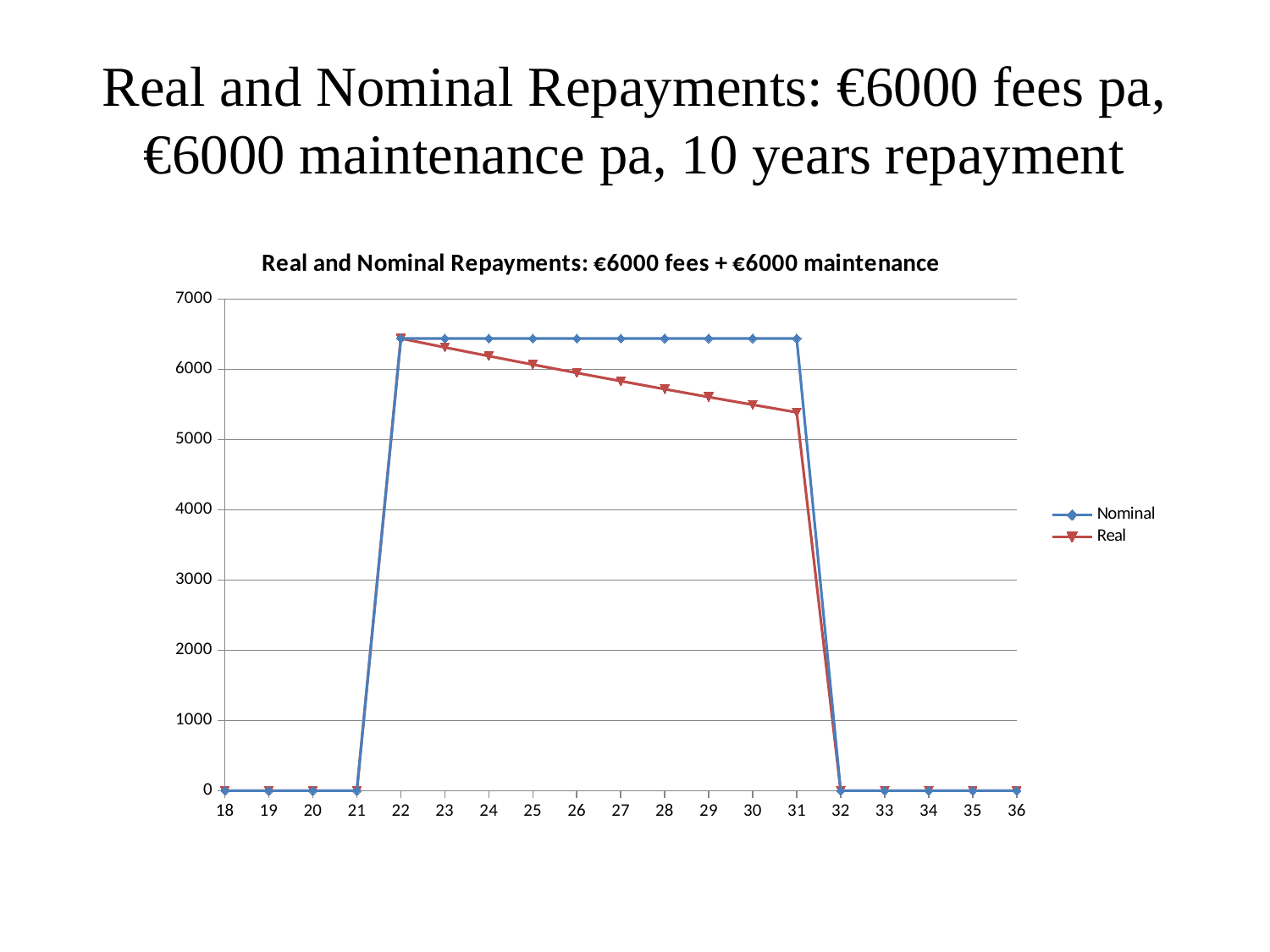
What is the Nominal value at 18? 0 How many points are labelled along the x axis? 19 How many series does the legend list? 2 What are the two series named in the legend? Nominal and Real At 30, which series has the larger value, Nominal or Real? Nominal Is the Real value at 31 greater or less than 5000? greater What kind of chart is shown on the slide? line chart Is the Real value at 31 greater or less than 6000? less What is the Real value at 36? 0 Does the Real series rise or fall between 22 and 31? fall What is the title printed above the chart? Real and Nominal Repayments: €6000 fees + €6000 maintenance Is the Nominal value at 25 greater or less than 6000? greater